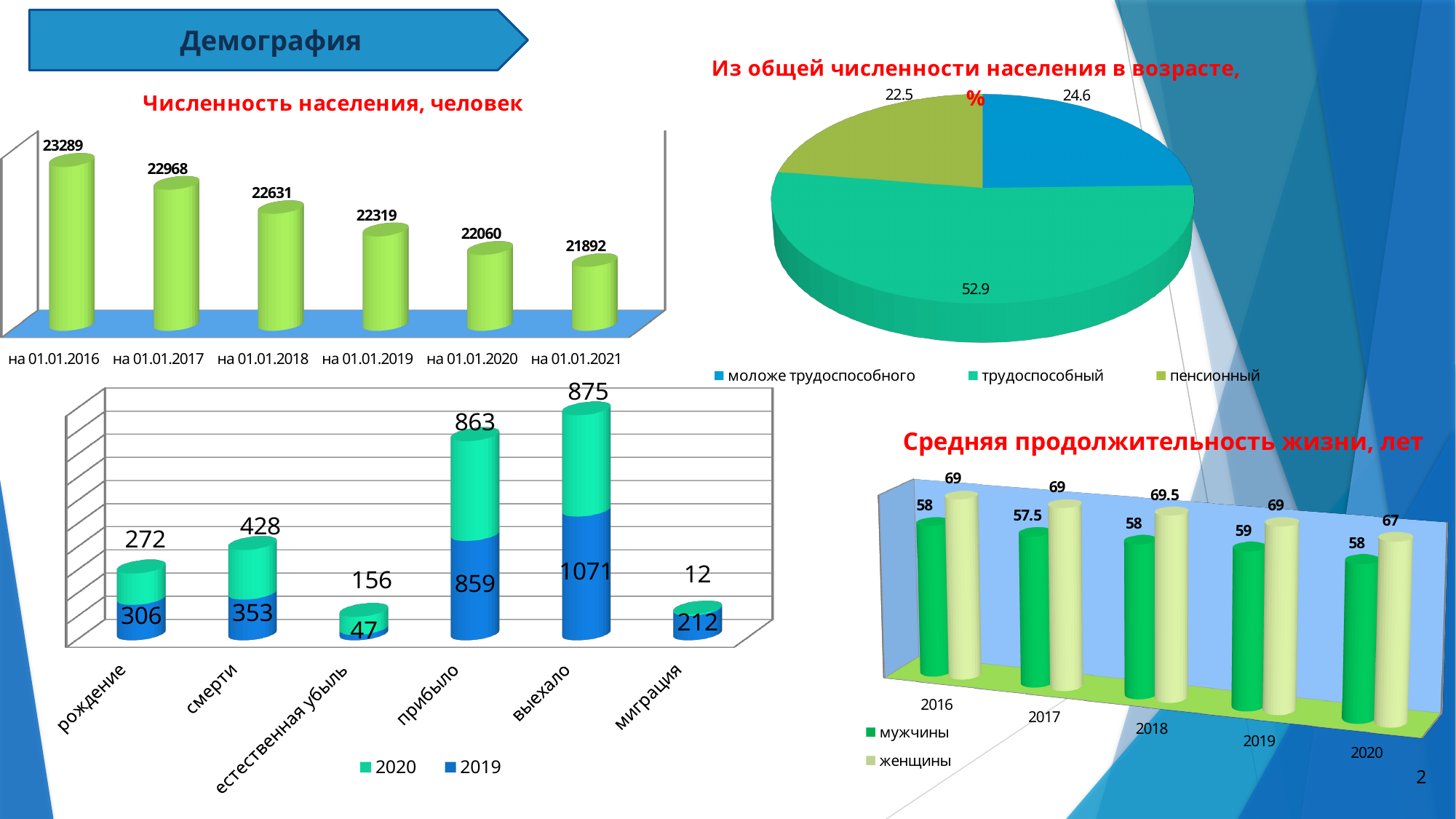
In the stacked bar chart at the bottom left, what is the total of the stacked bar for 'смерти'? 781 In the stacked bar chart at the bottom left, which is larger for 'миграция': the 2019 value or the 2020 value? 2019 In the pie chart titled 'Из общей численности населения в возрасте, %', which category has the smallest slice? пенсионный In the chart titled 'Средняя продолжительность жизни, лет', what is the value for 'женщины' in 2018? 69.5 In the chart titled 'Численность населения, человек', what is the value for 'на 01.01.2016'? 23289 In the stacked bar chart at the bottom left, what is the 2019 value for 'выехало'? 1071 In the pie chart titled 'Из общей численности населения в возрасте, %', what is the share for 'трудоспособный'? 52.9 In the chart titled 'Численность населения, человек', what is the value for 'на 01.01.2021'? 21892 In the chart titled 'Численность населения, человек', what is the difference between the values for 'на 01.01.2016' and 'на 01.01.2017'? 321 In the chart titled 'Численность населения, человек', how many bars are plotted? 6 In the chart titled 'Средняя продолжительность жизни, лет', how many series does the legend list? 2 In the chart titled 'Численность населения, человек', do the values rise or fall from 'на 01.01.2016' to 'на 01.01.2021'? fall